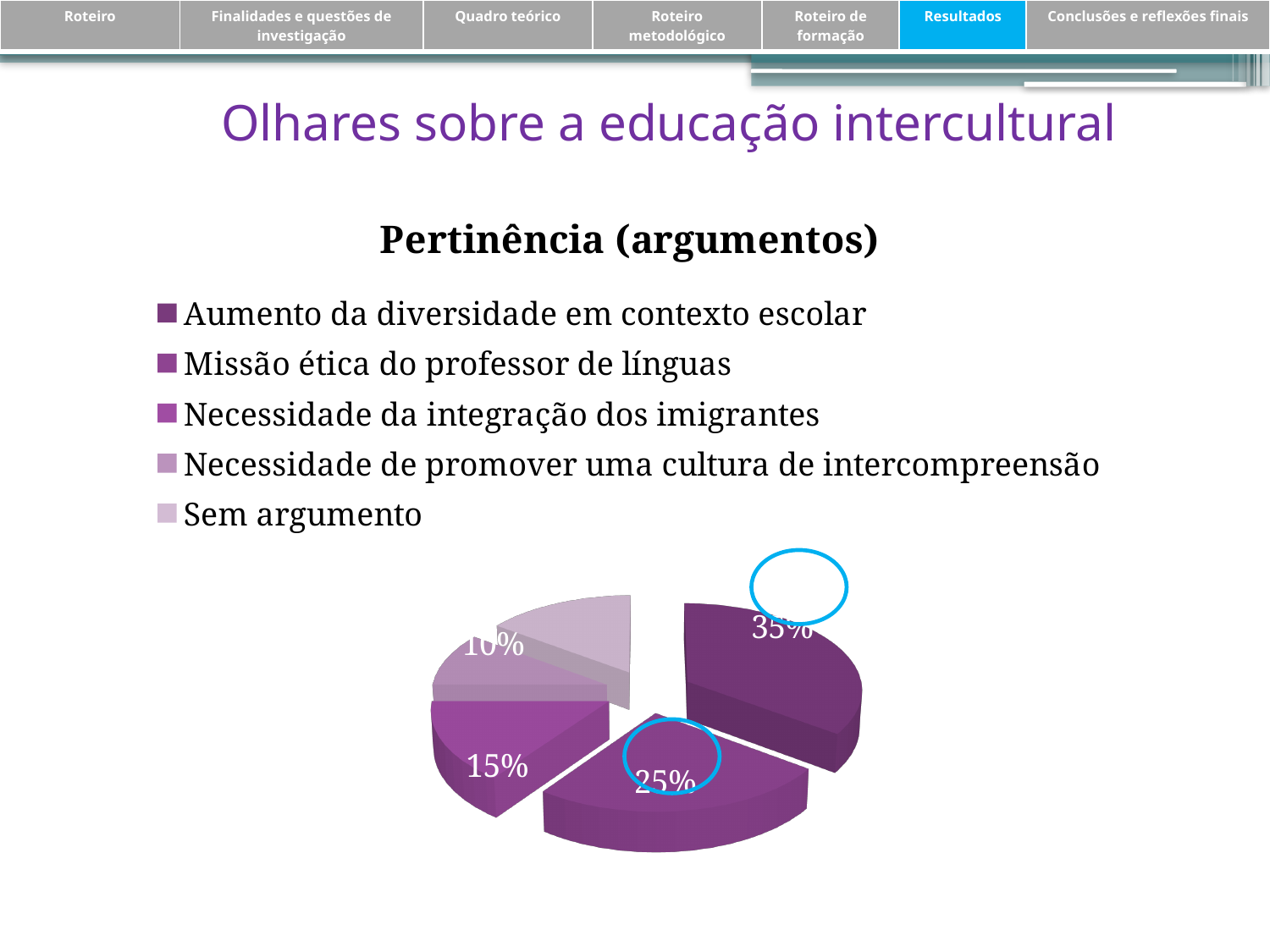
What percentage is shown for the largest slice of the pie? 35% What is the title of the chart? Pertinência (argumentos) What is the difference in percentage points between the 35% slice and the 25% slice? 10 How many categories does the chart legend list? 5 Is the share for 'Aumento da diversidade em contexto escolar' greater or less than 30%? greater Which category has the largest slice of the pie? Aumento da diversidade em contexto escolar What kind of chart is shown on the slide? pie chart Which is larger: the slice for 'Aumento da diversidade em contexto escolar' or the slice for 'Missão ética do professor de línguas'? Aumento da diversidade em contexto escolar Which legend entry is listed last in the chart legend? Sem argumento What share of the pie does 'Missão ética do professor de línguas' represent? 25%